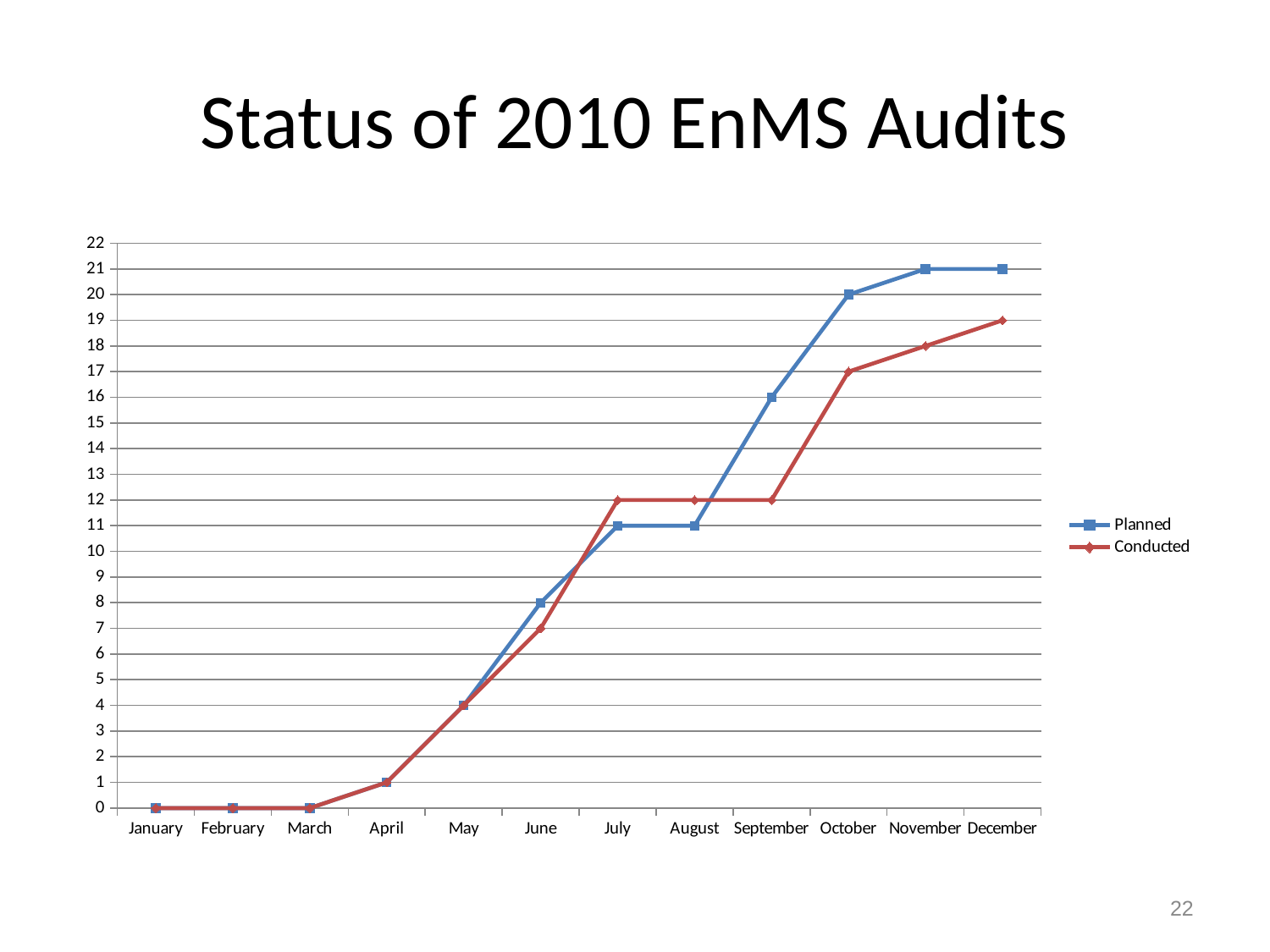
How many series does the legend list? 2 Does the Conducted series rise or fall from April to December? Rise What is the title of the chart? Status of 2010 EnMS Audits What is the Planned value for October? 20 What kind of chart is shown on the slide? Line chart What is the Planned value for September? 16 In July, which is larger, the Planned value or the Conducted value? Conducted In which month does the Planned series first reach its highest value of 21? November What is the Conducted value for June? 7 How many months are shown on the x axis? 12 What is the difference between the Planned and Conducted values in December? 2 What is the Conducted value for December? 19